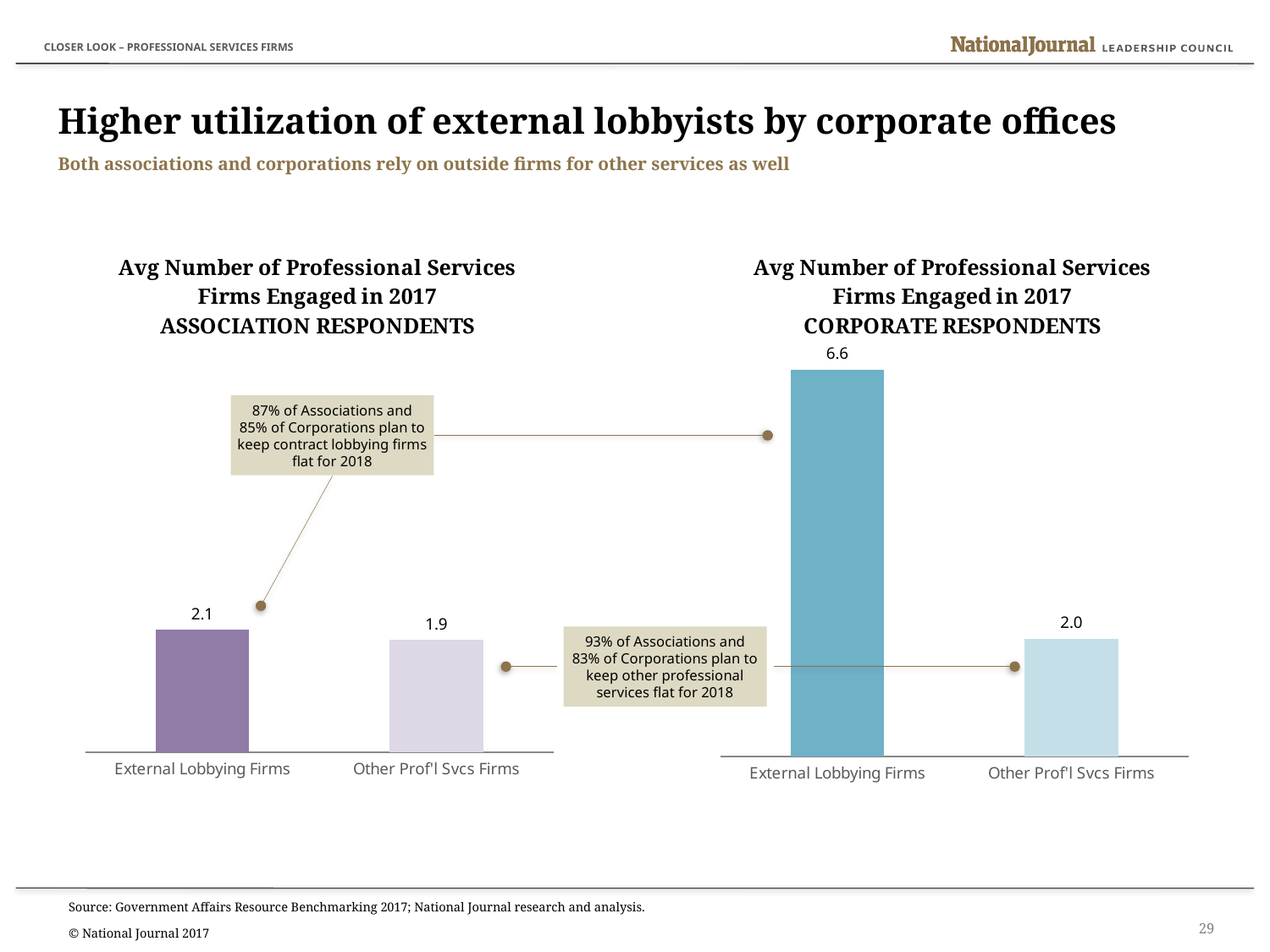
What type of chart is the Corporate Respondents chart? Bar chart In the Association Respondents chart, what is the average number of External Lobbying Firms engaged in 2017? 2.1 How many categories are shown in the Association Respondents chart? 2 In the Corporate Respondents chart, which category has the lowest value? Other Prof'l Svcs Firms In the Association Respondents chart, what is the difference between External Lobbying Firms and Other Prof'l Svcs Firms? 0.2 In the Association Respondents chart, what is the value for Other Prof'l Svcs Firms? 1.9 In the Corporate Respondents chart, which category has the highest value? External Lobbying Firms In the Corporate Respondents chart, what is the difference between External Lobbying Firms and Other Prof'l Svcs Firms? 4.6 According to the callout on the slide, what percentage of Associations plan to keep contract lobbying firms flat for 2018? 87% In the Corporate Respondents chart, what is the value for External Lobbying Firms? 6.6 In the Corporate Respondents chart, what is the value for Other Prof'l Svcs Firms? 2.0 Which is larger: the External Lobbying Firms value for Corporate Respondents or for Association Respondents? Corporate Respondents